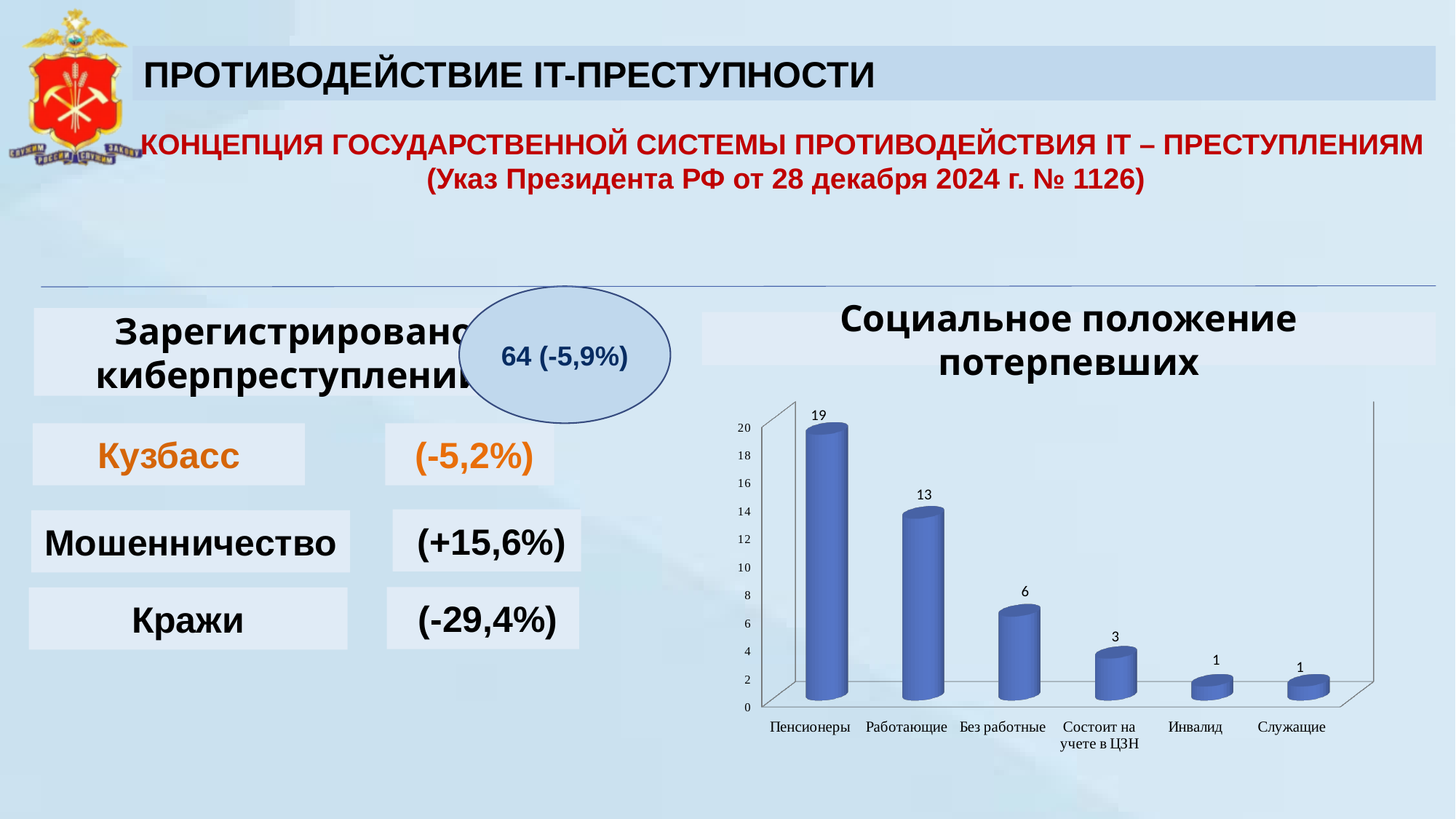
What is the value for Инвалид in the chart 'Социальное положение потерпевших'? 1 Do the values in the chart 'Социальное положение потерпевших' rise or fall from left to right? Fall Which is larger in the chart 'Социальное положение потерпевших': Без работные or Состоит на учете в ЦЗН? Без работные Which category has the highest value in the chart 'Социальное положение потерпевших'? Пенсионеры What is the value for Без работные in the chart 'Социальное положение потерпевших'? 6 What kind of chart is 'Социальное положение потерпевших'? Bar chart What is the value for Состоит на учете в ЦЗН in the chart 'Социальное положение потерпевших'? 3 How many categories are shown in the chart 'Социальное положение потерпевших'? 6 What is the title of the chart on the right side of the slide? Социальное положение потерпевших What is the value for Пенсионеры in the chart 'Социальное положение потерпевших'? 19 What is the value for Работающие in the chart 'Социальное положение потерпевших'? 13 What is the difference between the values for Пенсионеры and Работающие in the chart 'Социальное положение потерпевших'? 6